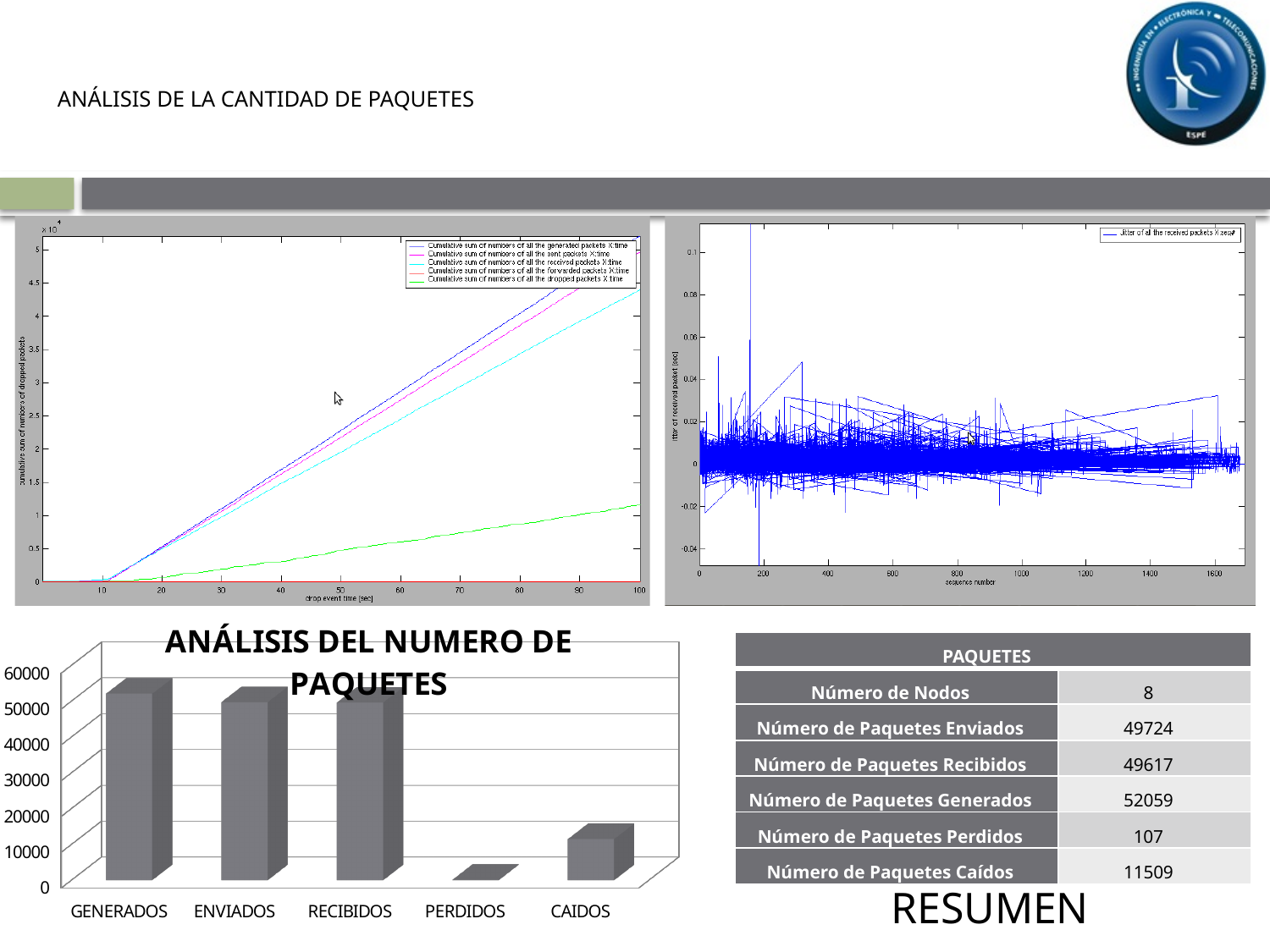
In the bottom-left bar chart 'ANÁLISIS DEL NUMERO DE PAQUETES', is the value for CAIDOS greater or less than 10000? greater In the top-left chart, do the cumulative sum lines rise or fall as drop event time increases? rise In the bottom-left bar chart 'ANÁLISIS DEL NUMERO DE PAQUETES', which is larger, RECIBIDOS or CAIDOS? RECIBIDOS In the bottom-left bar chart 'ANÁLISIS DEL NUMERO DE PAQUETES', is the value for GENERADOS greater or less than 50000? greater In the bottom-left bar chart 'ANÁLISIS DEL NUMERO DE PAQUETES', is the value for PERDIDOS greater or less than 10000? less How many series does the legend of the top-left chart (cumulative sum of packets vs drop event time) list? 5 What is the x-axis label of the top-right chart showing jitter of the received packets? sequence number In the bottom-left bar chart 'ANÁLISIS DEL NUMERO DE PAQUETES', which category has the lowest bar? PERDIDOS In the bottom-left bar chart 'ANÁLISIS DEL NUMERO DE PAQUETES', which category has the highest bar? GENERADOS In the bottom-left bar chart 'ANÁLISIS DEL NUMERO DE PAQUETES', which is larger, CAIDOS or PERDIDOS? CAIDOS In the bottom-left bar chart 'ANÁLISIS DEL NUMERO DE PAQUETES', how many categories are shown on the x axis? 5 What kind of chart is the bottom-left chart titled 'ANÁLISIS DEL NUMERO DE PAQUETES'? bar chart